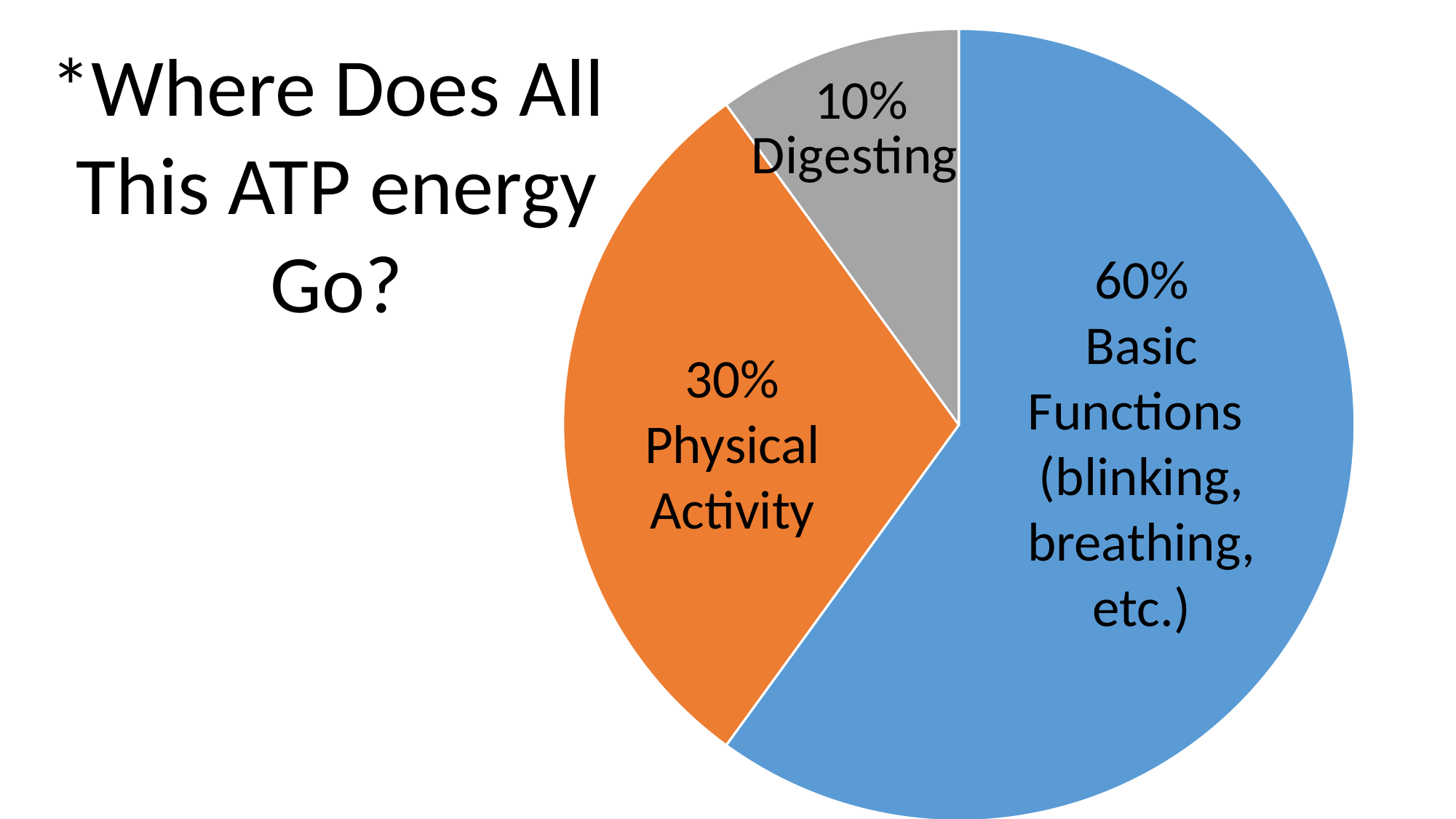
Which category has the smallest share of the pie? Digesting What is the difference between the Physical Activity share and the Digesting share? 20% What share of ATP energy goes to Basic Functions? 60% Which is larger, the share for Physical Activity or the share for Digesting? Physical Activity How many slices does the pie chart have? 3 What is the difference between the Basic Functions share and the Physical Activity share? 30% What share of ATP energy goes to Physical Activity? 30% What colour is the Physical Activity slice? orange What kind of chart is shown on the slide? pie chart What share of ATP energy goes to Digesting? 10% Which category has the largest share of the pie? Basic Functions What is the title text shown next to the pie chart? *Where Does All This ATP energy Go?